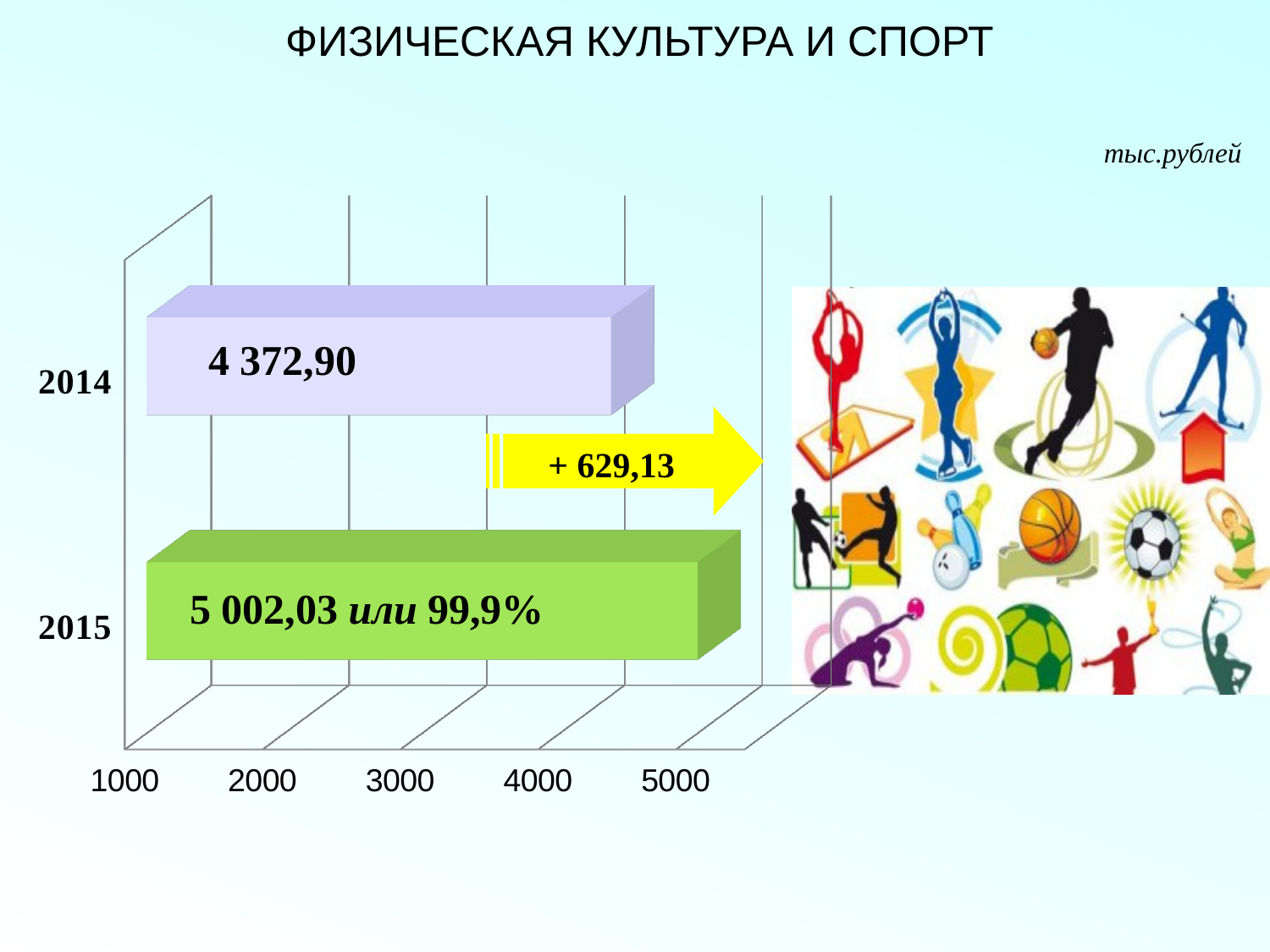
Does the value rise or fall from 2014 to 2015? rise What change is shown on the arrow between the 2014 and 2015 bars? + 629,13 What is the value for 2015? 5 002,03 Which year has the higher value? 2015 What is the value for 2014? 4 372,90 How many years are shown in the chart? 2 In what units are the values on the chart expressed? тыс.рублей What kind of chart is shown on the slide? bar chart Is the value for 2014 greater or less than 4000? greater Which year has the lower value? 2014 What percentage is shown next to the 2015 value? 99,9% What is the difference between the 2015 and 2014 values? 629,13